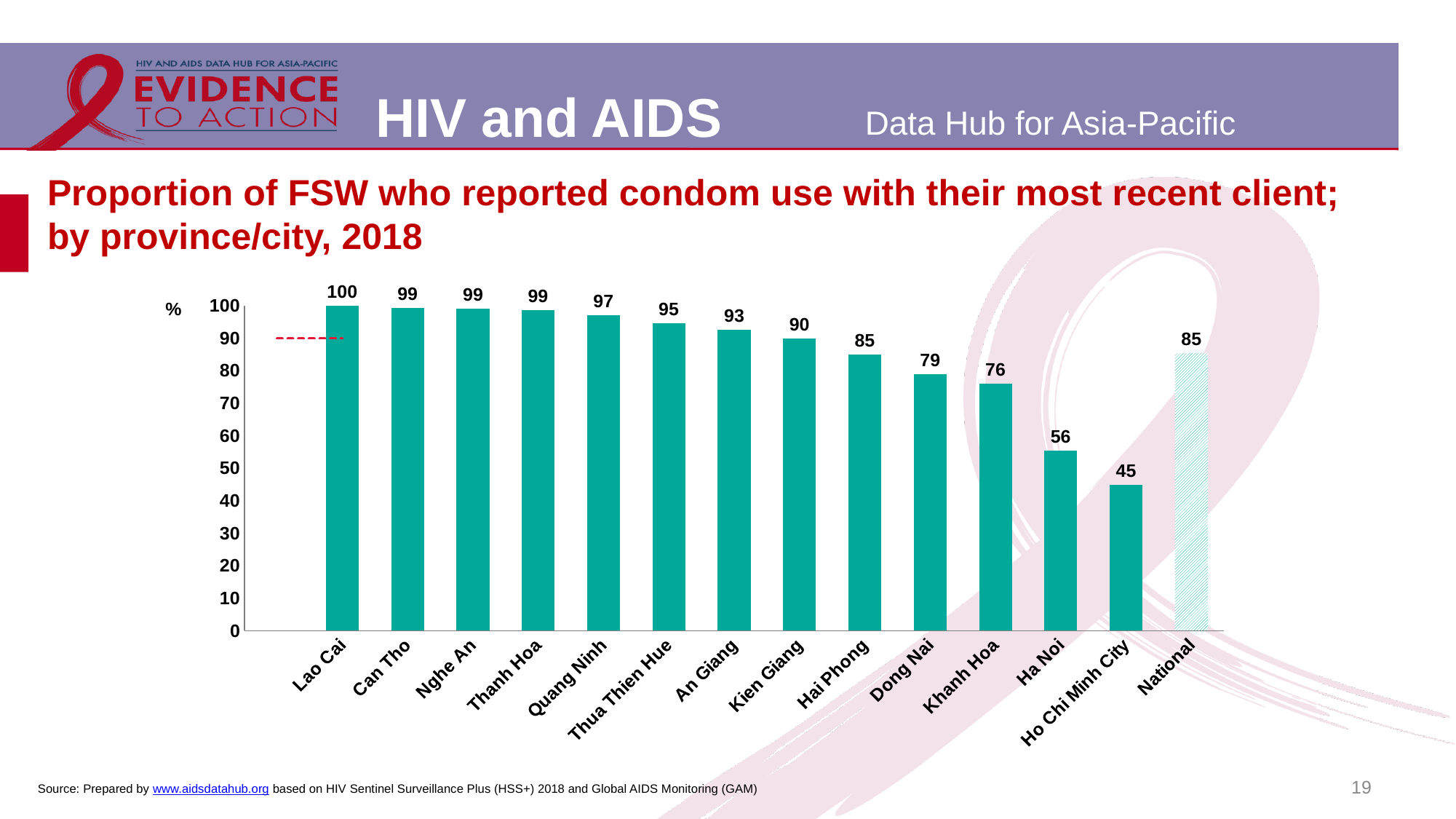
Which province/city has the highest value? Lao Cai Do the values generally rise or fall from Lao Cai to Ho Chi Minh City along the x axis? Fall What is the difference between the values for Ha Noi and Ho Chi Minh City? 11 What is the value for Khanh Hoa? 76 Is the value for Ha Noi greater or less than 60? less How many bars are shown in the chart, including National? 14 What is the National value? 85 What kind of chart is shown on the slide? Bar chart What is the value for Lao Cai? 100 Which province/city has the lowest value? Ho Chi Minh City Which is larger, the value for Dong Nai or the value for Kien Giang? Kien Giang What is the value for Ho Chi Minh City? 45